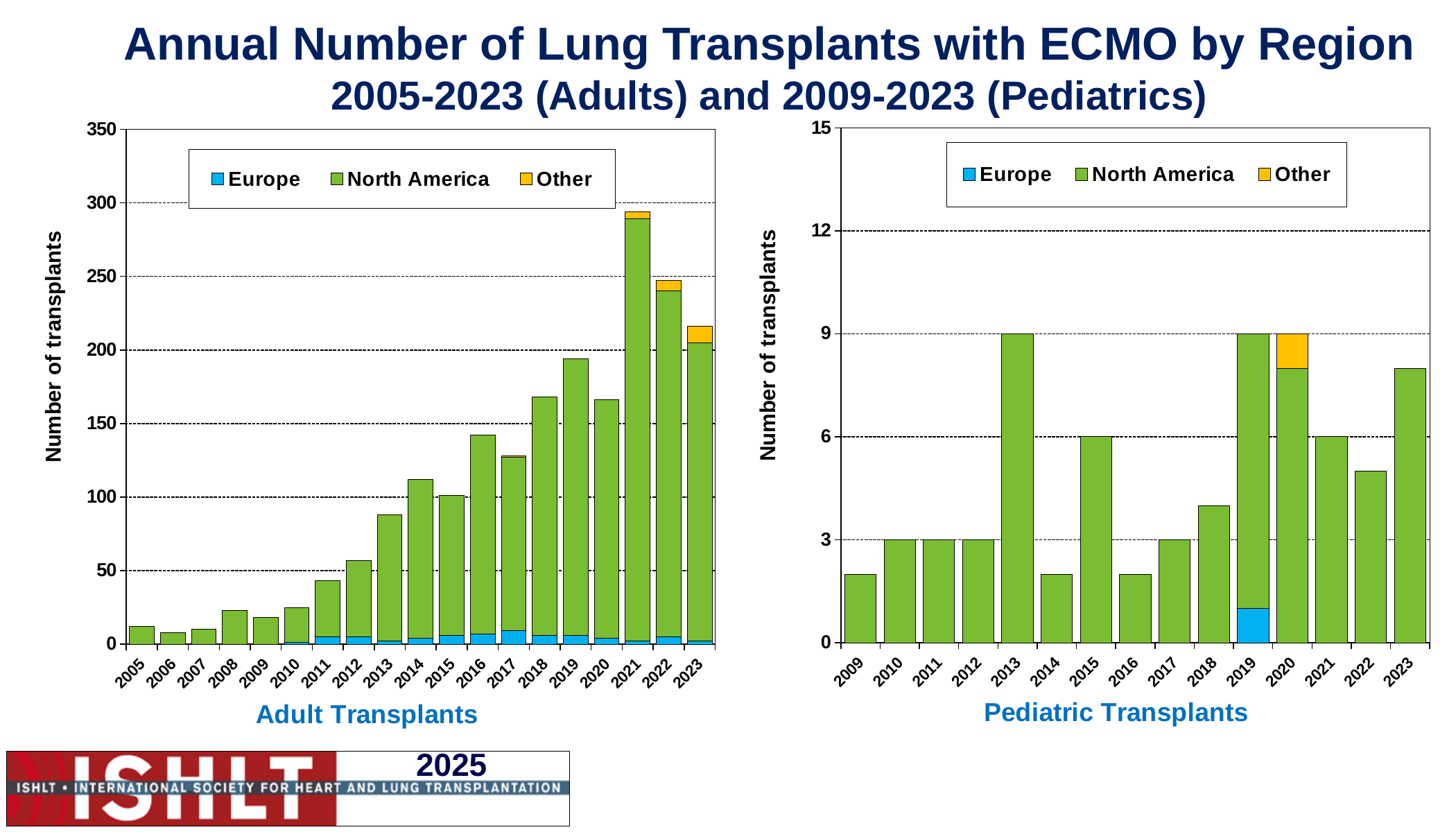
In the Pediatric Transplants chart, what is the total number of transplants in 2020? 9 In the Adult Transplants chart, which year has the lowest total number of transplants? 2006 What kind of chart is the Adult Transplants chart? bar chart How many years are shown on the x axis of the Pediatric Transplants chart? 15 In the Pediatric Transplants chart, what is the number of transplants in 2015? 6 In the Pediatric Transplants chart, what is the number of transplants in 2013? 9 In the Adult Transplants chart, is the total for 2023 greater or less than 200? greater How many series does the legend of the Pediatric Transplants chart list? 3 In the Adult Transplants chart, is the total for 2019 greater or less than 200? less How many years are shown on the x axis of the Adult Transplants chart? 19 In the Adult Transplants chart, which year has the highest total number of transplants? 2021